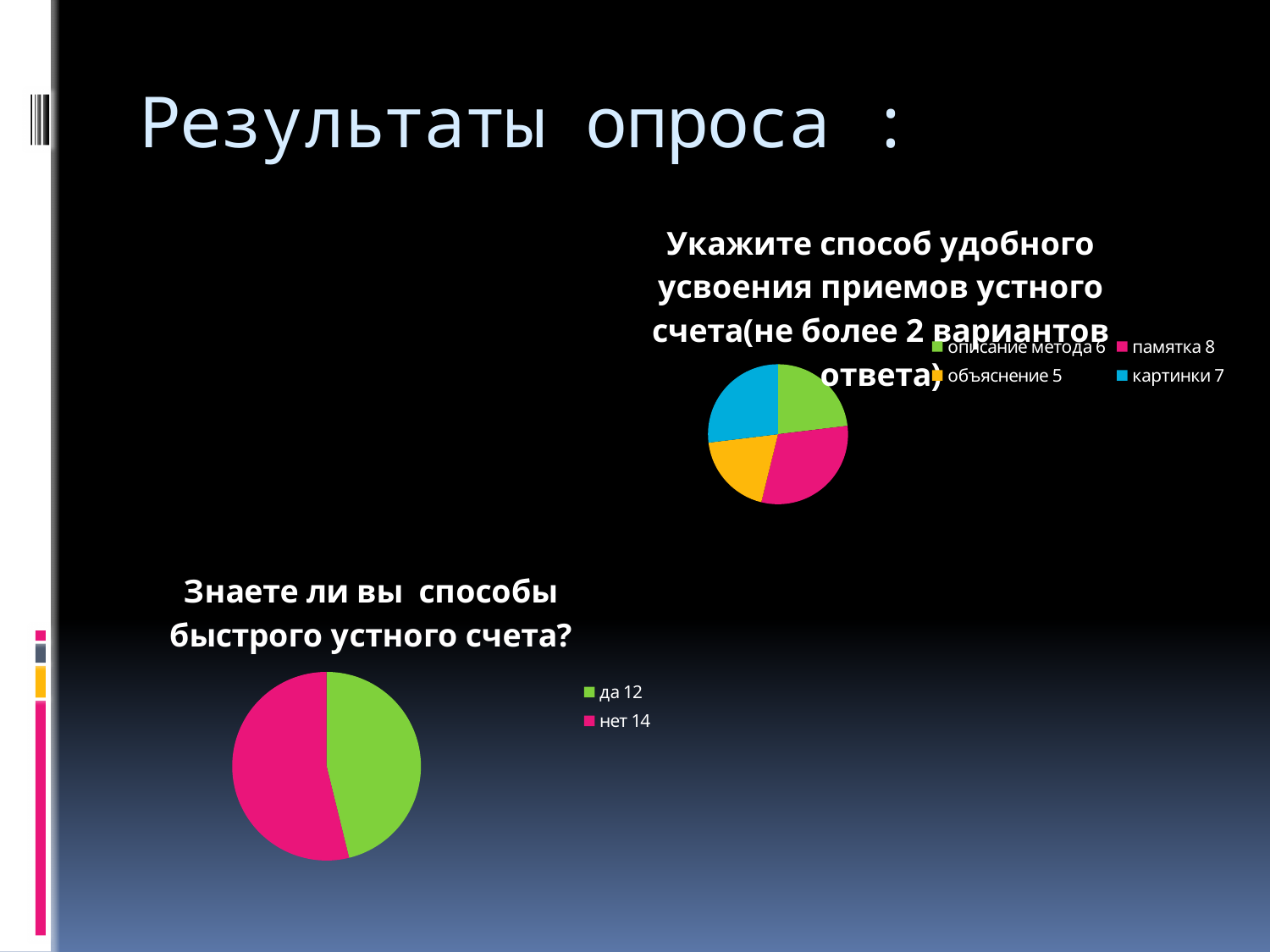
In the bottom-left chart "Знаете ли вы способы быстрого устного счета?", what is the difference between the values for "нет" and "да"? 2 What kind of chart is the bottom-left chart titled "Знаете ли вы способы быстрого устного счета?"? pie chart In the bottom-left chart "Знаете ли вы способы быстрого устного счета?", what is the value for "нет"? 14 In the top-right chart "Укажите способ удобного усвоения приемов устного счета", what is the difference between the values for "картинки" and "описание метода"? 1 In the top-right chart "Укажите способ удобного усвоения приемов устного счета", which category has the highest value? памятка In the top-right chart "Укажите способ удобного усвоения приемов устного счета", which category has the lowest value? объяснение In the top-right chart "Укажите способ удобного усвоения приемов устного счета", what is the value for "памятка"? 8 How many entries does the legend of the bottom-left chart "Знаете ли вы способы быстрого устного счета?" list? 2 How many categories are shown in the top-right chart "Укажите способ удобного усвоения приемов устного счета"? 4 In the top-right chart "Укажите способ удобного усвоения приемов устного счета", what is the value for "объяснение"? 5 In the bottom-left chart "Знаете ли вы способы быстрого устного счета?", which answer has the larger value, "да" or "нет"? нет In the bottom-left chart "Знаете ли вы способы быстрого устного счета?", what is the value for "да"? 12